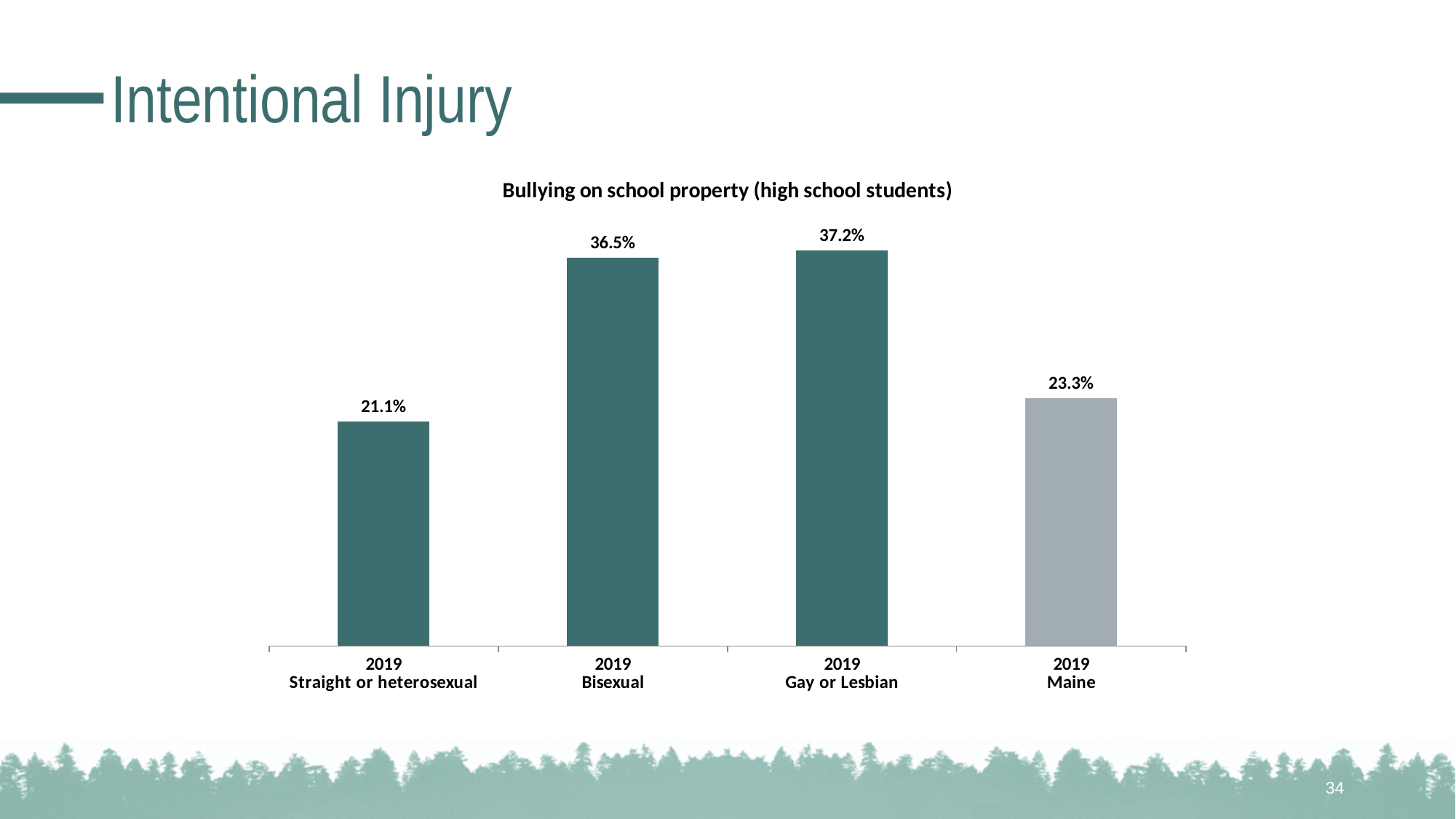
What is the value for Bisexual students in the chart? 36.5% Which is larger, the value for Bisexual or the value for Maine? Bisexual Which category has the lowest value? Straight or heterosexual What is the difference between the Maine value and the Straight or heterosexual value? 2.2% What is the difference between the Bisexual value and the Straight or heterosexual value? 15.4% How many bars are shown in the chart? 4 What is the value for Maine overall? 23.3% What is the value for Straight or heterosexual students? 21.1% Which category has the highest value? Gay or Lesbian What is the title of the chart? Bullying on school property (high school students) What kind of chart is shown on the slide? Bar chart What is the value for Gay or Lesbian students? 37.2%